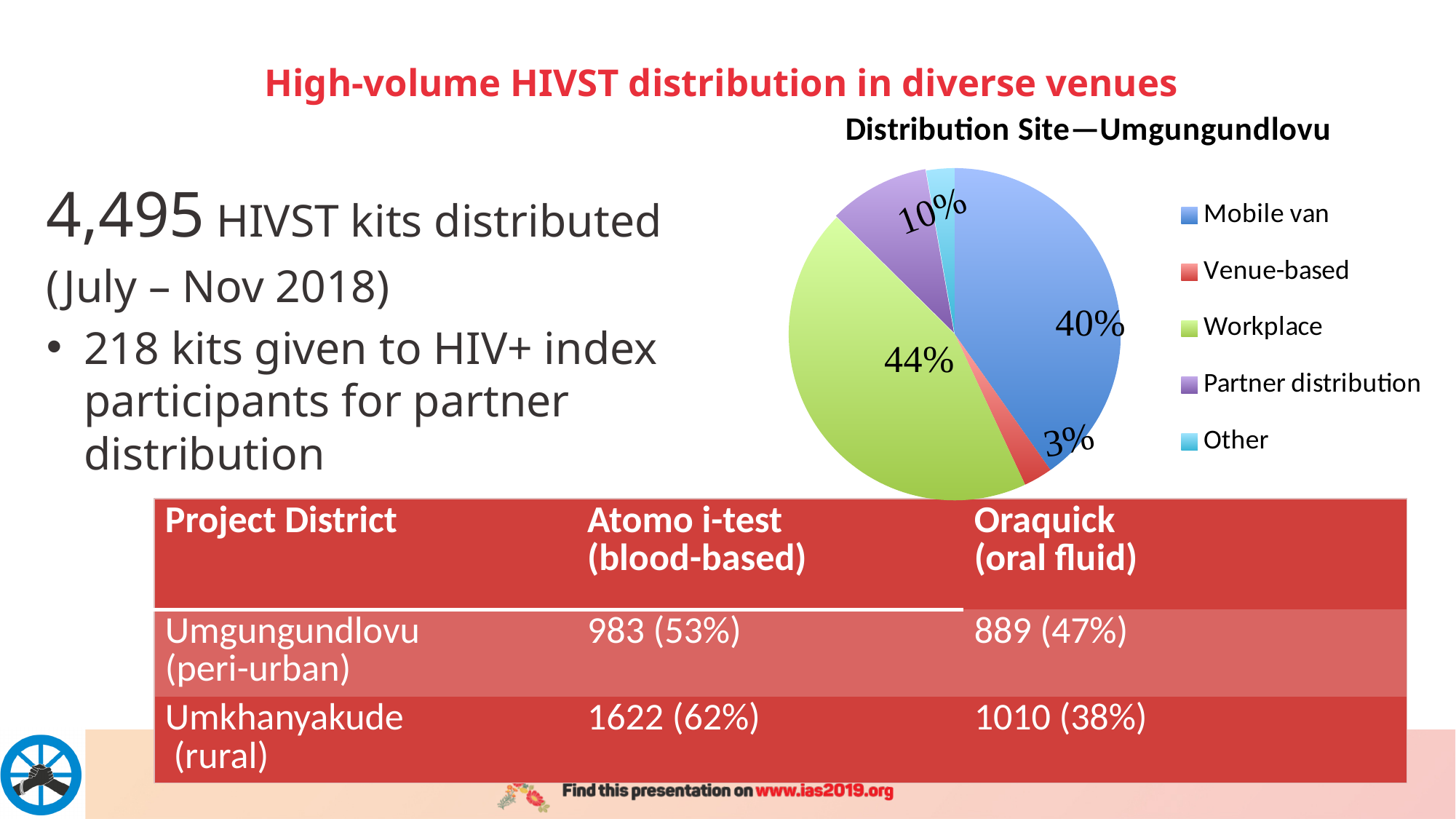
How many categories does the legend of the pie chart list? 5 What share of the pie does Mobile van account for? 40% What is the title of the pie chart? Distribution Site—Umgungundlovu What type of chart is shown on the slide? pie chart Which is larger, the share for Workplace or the share for Mobile van? Workplace Which colour represents Workplace in the pie chart? green Which distribution site has the largest share of the pie? Workplace What share of the pie does Venue-based account for? 3% What is the difference in percentage points between the Mobile van share and the Partner distribution share? 30% What share of the pie does Workplace account for? 44% What is the difference in percentage points between the Workplace share and the Mobile van share? 4% What share of the pie does Partner distribution account for? 10%